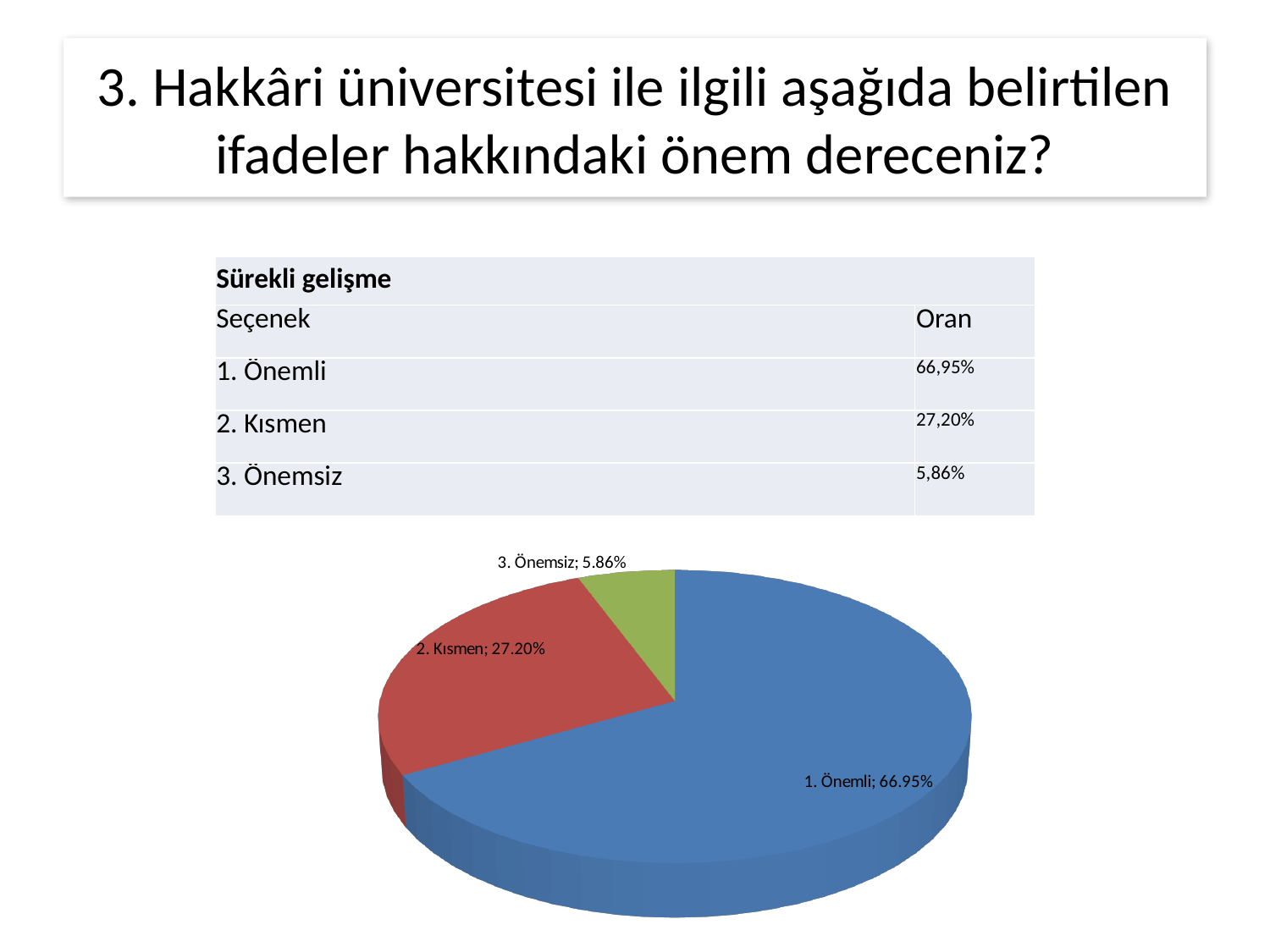
Which is larger in the pie chart, "2. Kısmen" or "3. Önemsiz"? 2. Kısmen What is the value shown for the slice labelled "1. Önemli" in the pie chart? 66.95% Which slice of the pie chart is the smallest? 3. Önemsiz What is the difference between the values for "2. Kısmen" and "3. Önemsiz" in the pie chart? 21.34% What colour is the "2. Kısmen" slice in the pie chart? Red Which slice of the pie chart is the largest? 1. Önemli What is the value shown for the slice labelled "3. Önemsiz" in the pie chart? 5.86% What kind of chart is shown on the slide? Pie chart What is the value shown for the slice labelled "2. Kısmen" in the pie chart? 27.20% What share of the pie does the "1. Önemli" slice represent? 66.95% How many slices does the pie chart have? 3 What is the difference between the values for "1. Önemli" and "2. Kısmen" in the pie chart? 39.75%